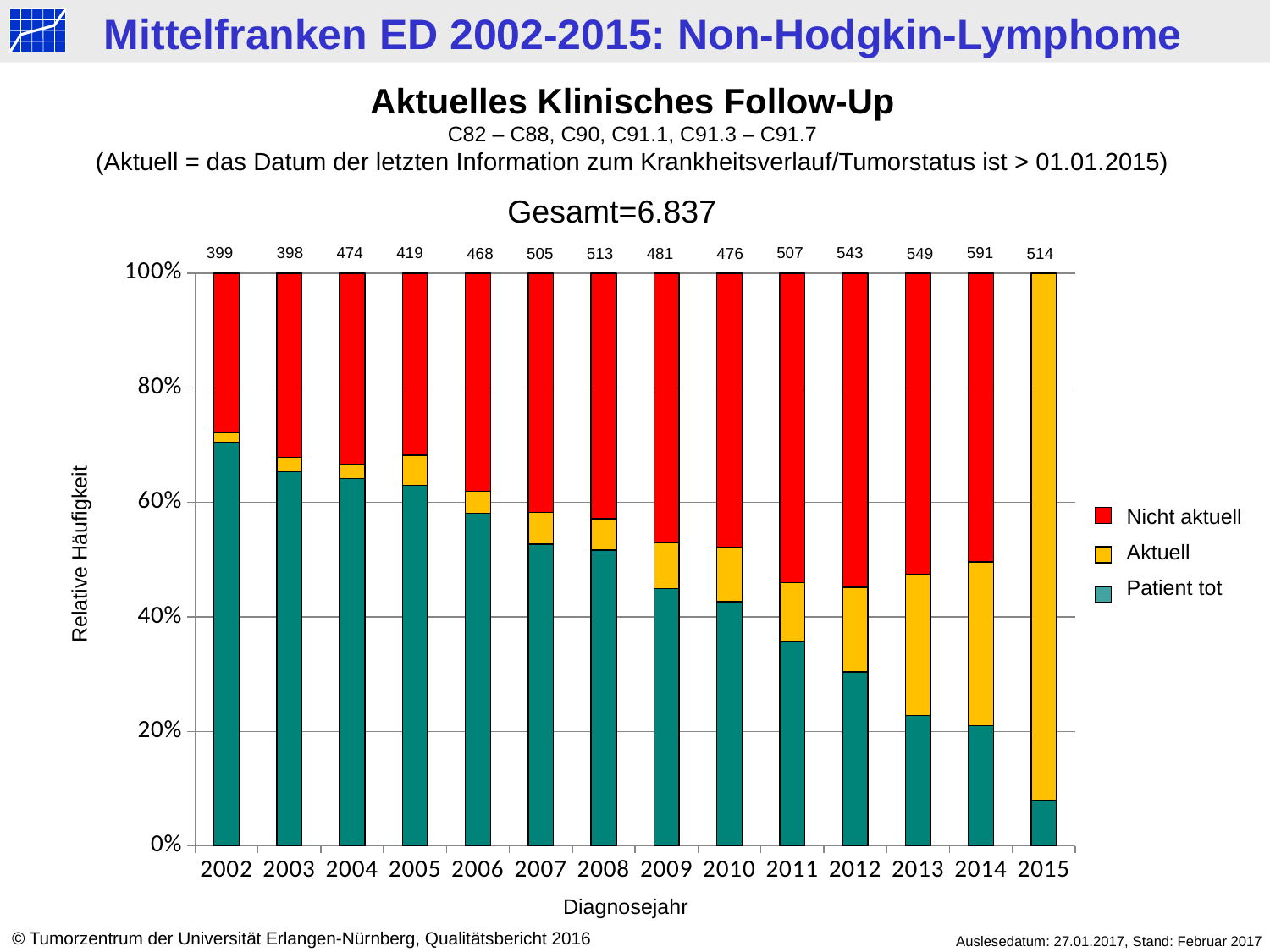
How many series does the legend list? 3 Which diagnosis year has the highest number printed above its bar? 2014 What is the number printed above the bar for 2008? 513 Is the 'Patient tot' share for 2015 greater or less than 20%? less Is the 'Patient tot' share for 2002 greater or less than 60%? greater What is the number printed above the bar for 2002? 399 Which diagnosis year has the lowest number printed above its bar? 2003 What kind of chart is shown on the slide? Stacked bar chart Which has a larger number printed above its bar, 2012 or 2009? 2012 What is the number printed above the bar for 2014? 591 What is the difference between the numbers printed above the bars for 2014 and 2003? 193 How many diagnosis years are shown on the x axis? 14